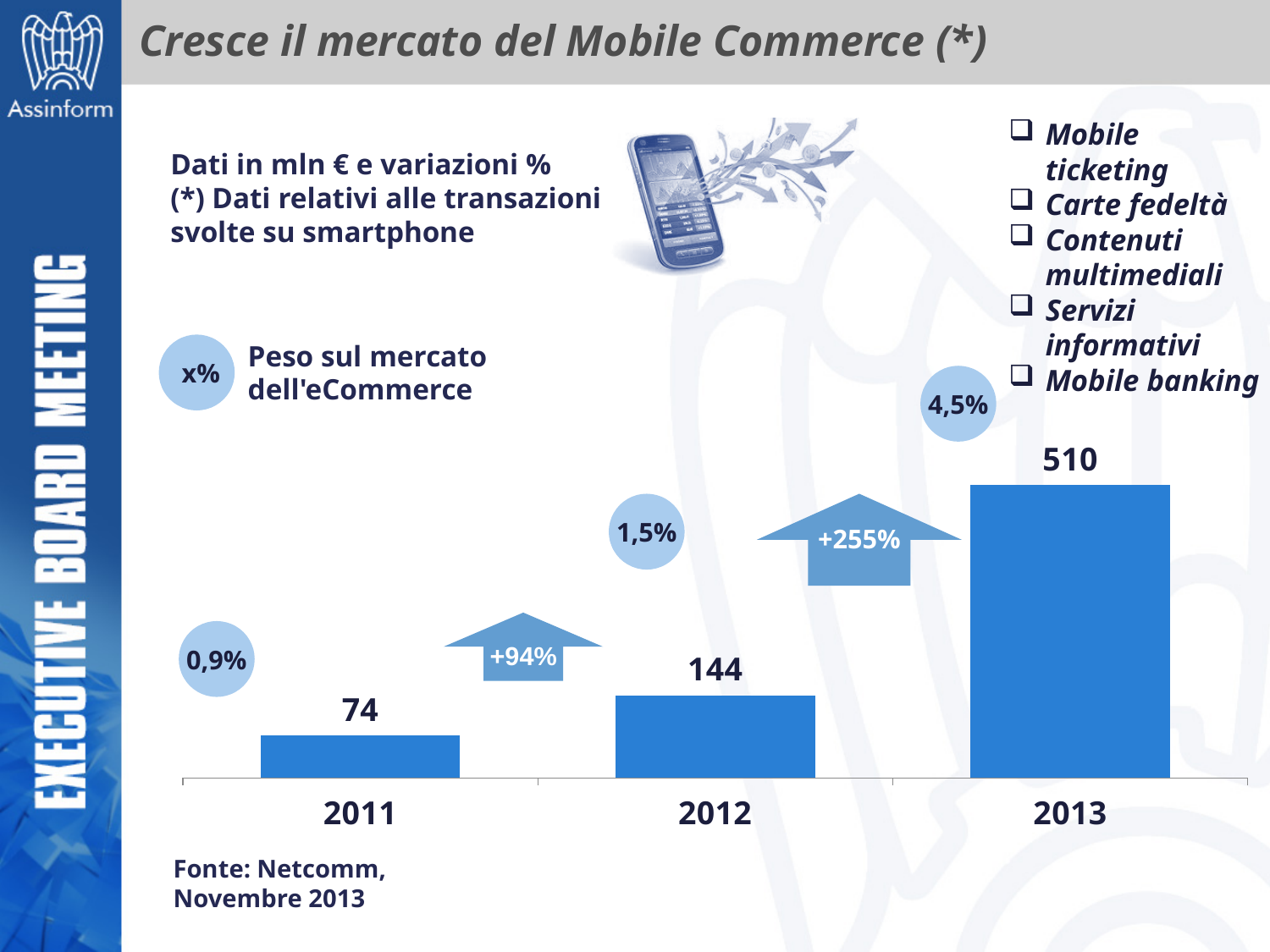
What is the value for 2011? 74 Which is larger, the value for 2012 or the value for 2011? 2012 What percentage change is shown between 2012 and 2013? +255% Which year has the lowest value? 2011 What kind of chart is shown on the slide? bar chart What is the value for 2013? 510 What is the difference between the values for 2012 and 2011? 70 Which year has the highest value? 2013 What is the difference between the values for 2013 and 2012? 366 What is the value for 2012? 144 Do the values rise or fall from 2011 to 2013? rise How many years are shown on the x axis? 3